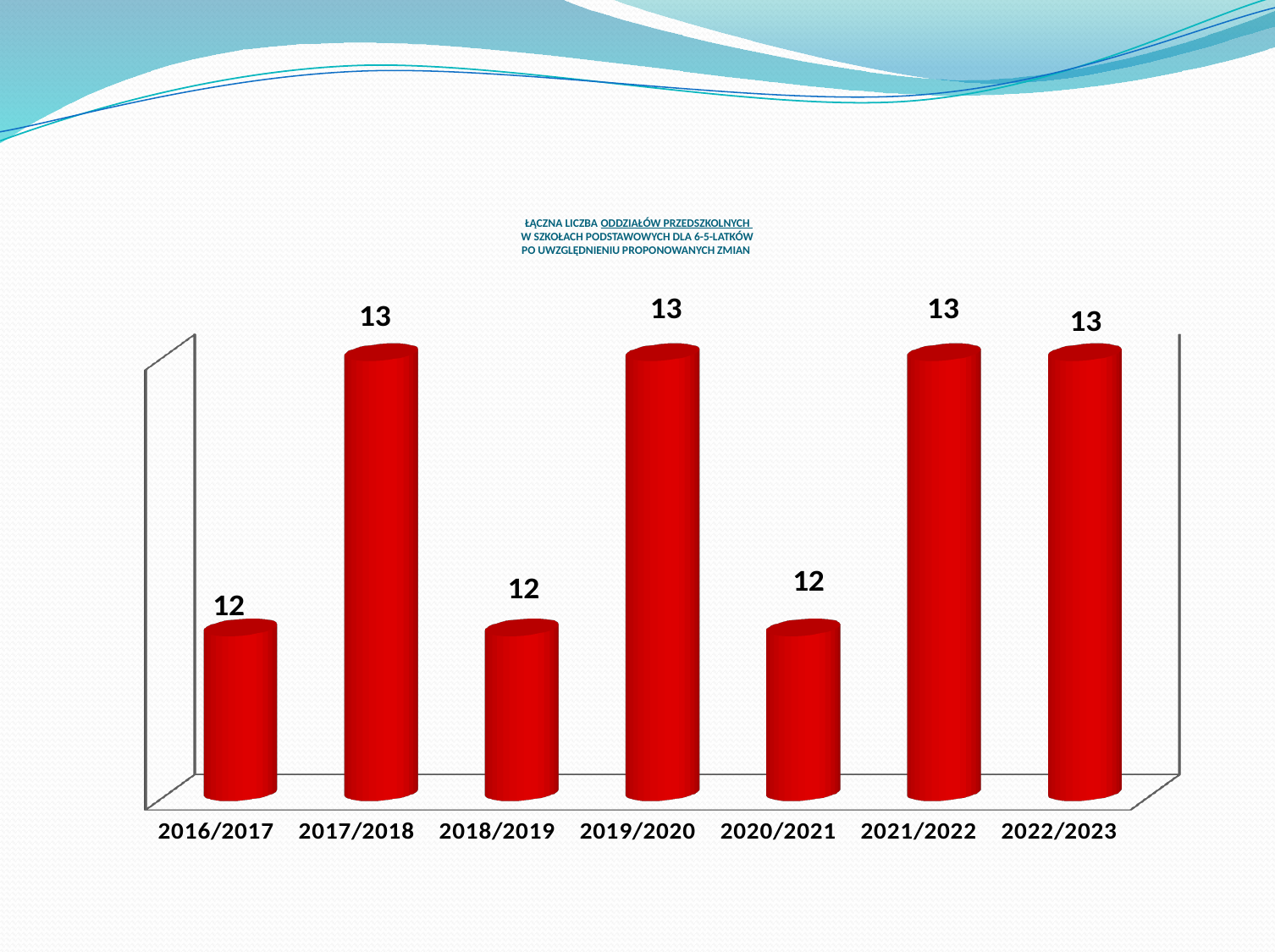
Do the values rise or fall between 2020/2021 and 2021/2022? rise What is the value for 2016/2017? 12 Which is larger, the value for 2020/2021 or the value for 2021/2022? 2021/2022 How many categories have a value of 13? 4 What is the value for 2020/2021? 12 What is the value for 2019/2020? 13 What is the difference between the values for 2017/2018 and 2018/2019? 1 How many categories are shown on the x axis? 7 What is the first category on the x axis? 2016/2017 What colour are the bars in the chart? red What is the value for 2022/2023? 13 What kind of chart is shown on the slide? bar chart